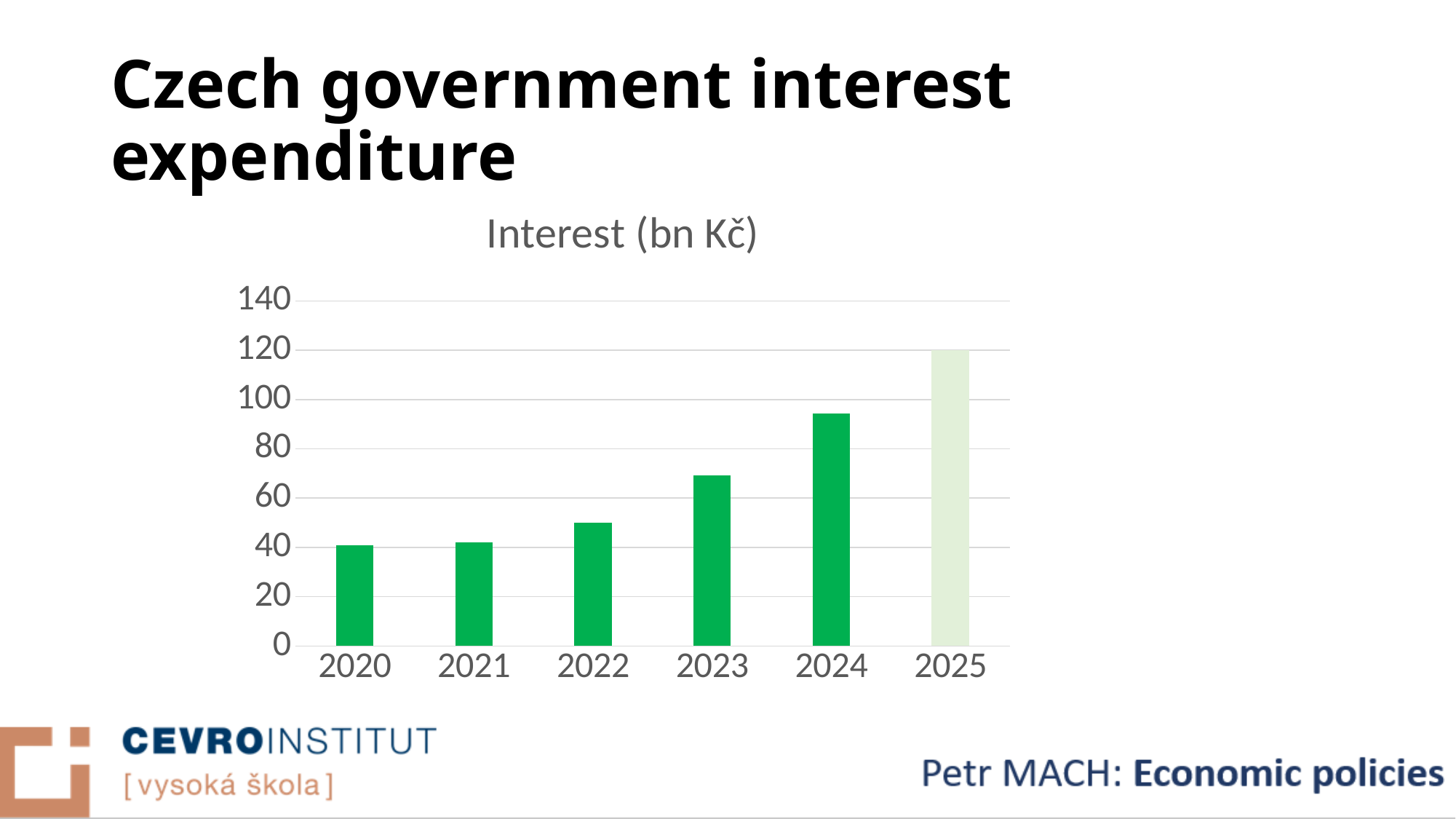
Do the values in the chart rise or fall from 2020 to 2025? rise Is the value for 2025 greater or less than 100? greater Which year's bar is drawn in a lighter shade than the others? 2025 Is the value for 2023 greater or less than 60? greater Which is larger, the value for 2023 or the value for 2024? 2024 Which year has the highest interest expenditure in the chart? 2025 What kind of chart is shown on the slide? bar chart What is the title of the chart? Interest (bn Kč) Is the value for 2024 greater or less than 80? greater How many years are shown on the x axis of the chart? 6